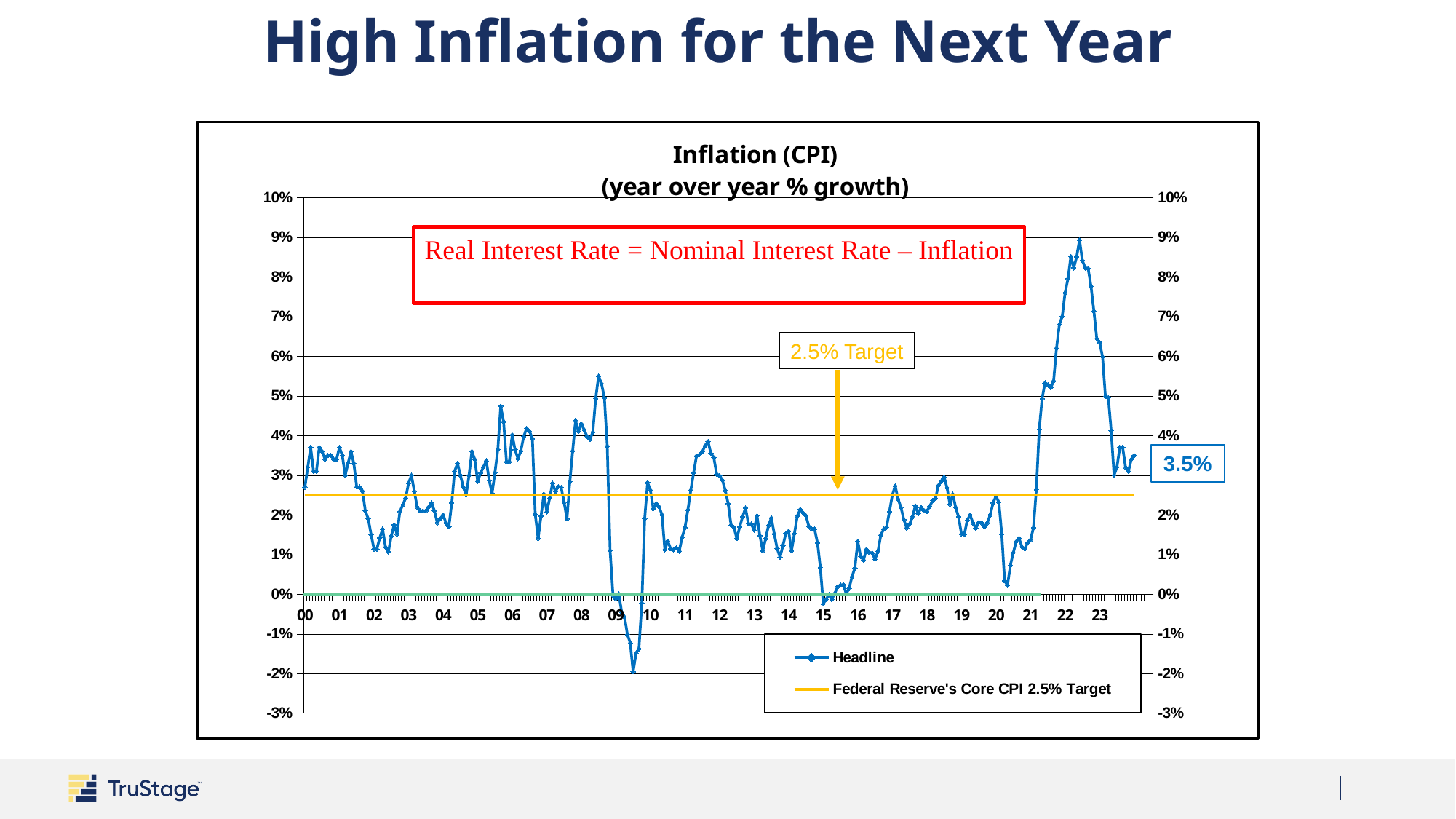
Is the Headline inflation value in early 2015 greater or less than 1%? less What is the title of the chart? Inflation (CPI) (year over year % growth) Is the peak Headline inflation value in 2022 greater or less than 8%? greater In which year does the Headline inflation line reach its highest point? 22 Does the Headline inflation line rise or fall from its 2022 peak to 2023? fall How many series does the legend list? 2 Which is larger, the Headline inflation peak in 2008 or the peak in 2022? 2022 What kind of chart is shown on the slide? line chart Is the lowest Headline inflation value in 2009 greater or less than -1%? less What value is the Federal Reserve's Core CPI target line set at? 2.5% In which year does the Headline inflation line reach its lowest point? 09 What is the most recent Headline inflation value labeled on the chart? 3.5%